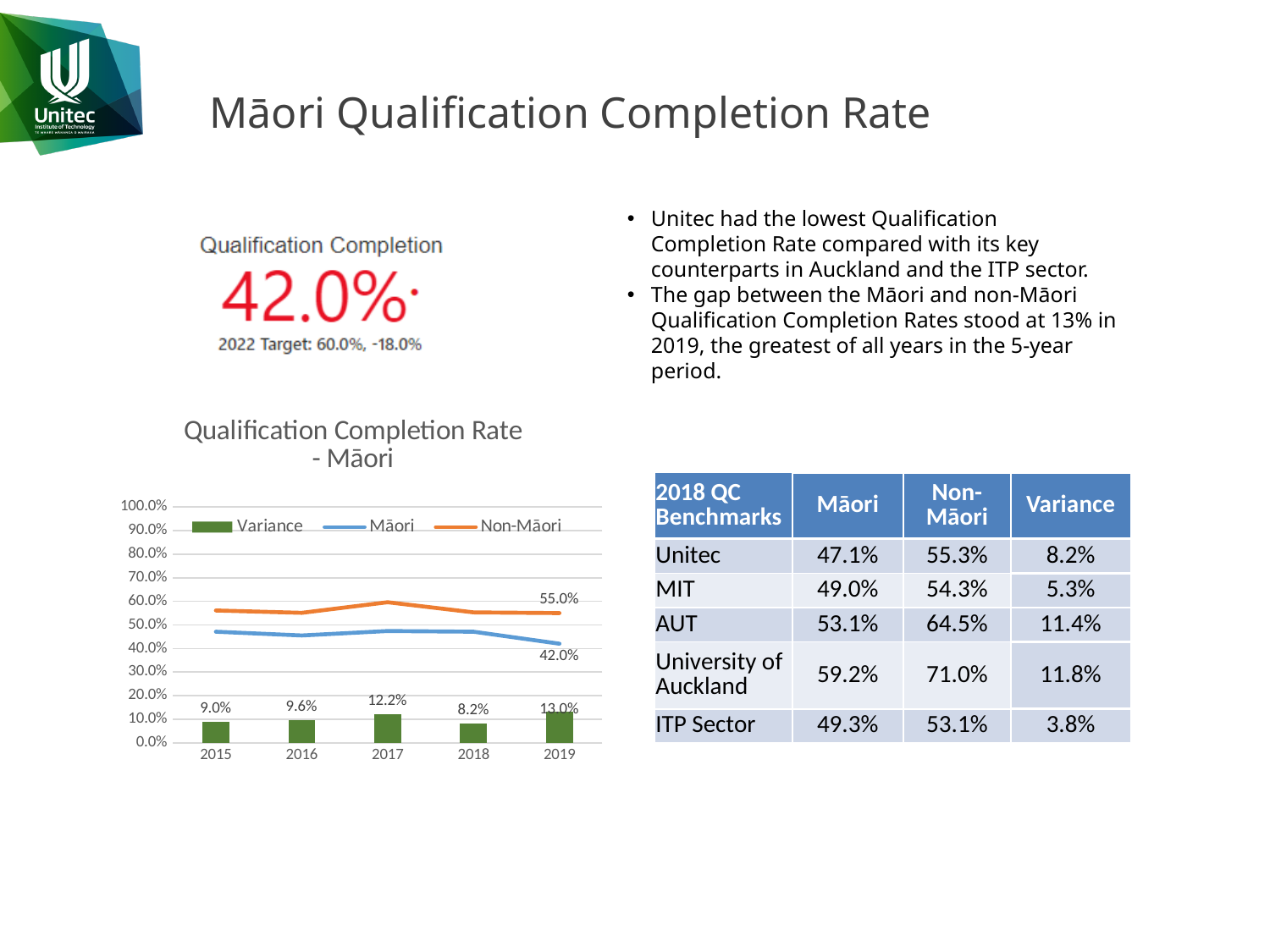
What is the Māori qualification completion rate shown for 2019 in the chart? 42.0% In which year is the Variance bar lowest in the Qualification Completion Rate - Māori chart? 2018 Is the Variance value for 2016 larger or smaller than the Variance value for 2017? smaller Is the Non-Māori value for 2017 greater or less than 50.0%? greater What is the Variance value for 2017 in the Qualification Completion Rate - Māori chart? 12.2% What is the Variance value for 2015 in the Qualification Completion Rate - Māori chart? 9.0% Which series in the Qualification Completion Rate - Māori chart is drawn as bars? Variance What is the Non-Māori qualification completion rate shown for 2019 in the chart? 55.0% How many years are shown on the x axis of the Qualification Completion Rate - Māori chart? 5 How many series does the legend of the Qualification Completion Rate - Māori chart list? 3 What is the difference between the Non-Māori and Māori rates in 2019 according to the chart's data labels? 13.0% In which year is the Variance bar highest in the Qualification Completion Rate - Māori chart? 2019